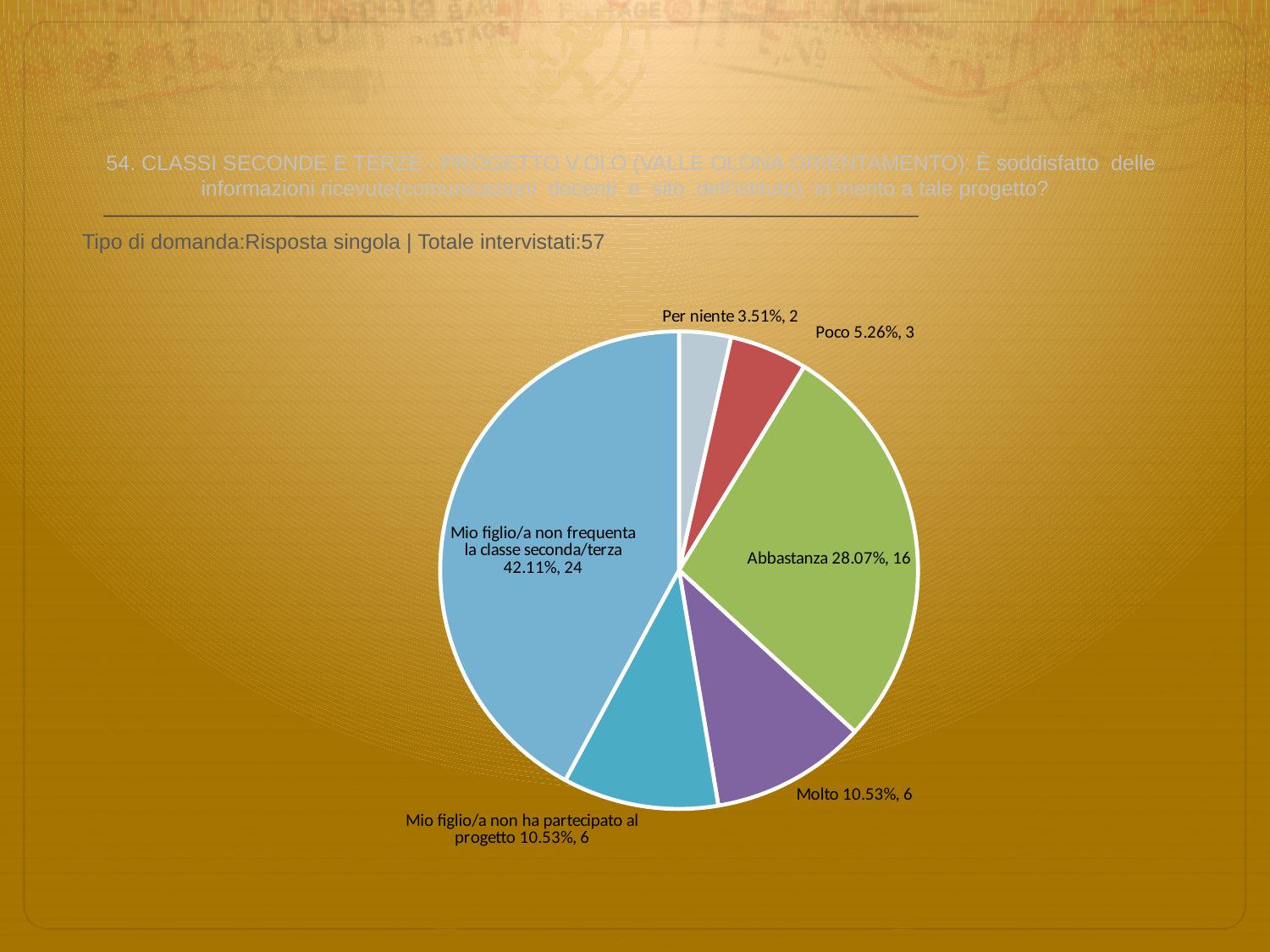
What percentage is shown for the "Abbastanza" slice? 28.07% Which has more respondents, "Poco" or "Per niente"? Poco Which category has the smallest slice of the pie? Per niente What type of chart is shown on the slide? pie chart What is the total number of respondents (Totale intervistati) stated on the slide? 57 What is the difference in number of respondents between "Abbastanza" and "Molto"? 10 How many respondents answered "Poco"? 3 How many respondents answered "Molto"? 6 What percentage is shown for "Per niente"? 3.51% How many slices does the pie chart have? 6 Which category has the largest slice of the pie? Mio figlio/a non frequenta la classe seconda/terza What share of the pie does "Mio figlio/a non ha partecipato al progetto" represent? 10.53%